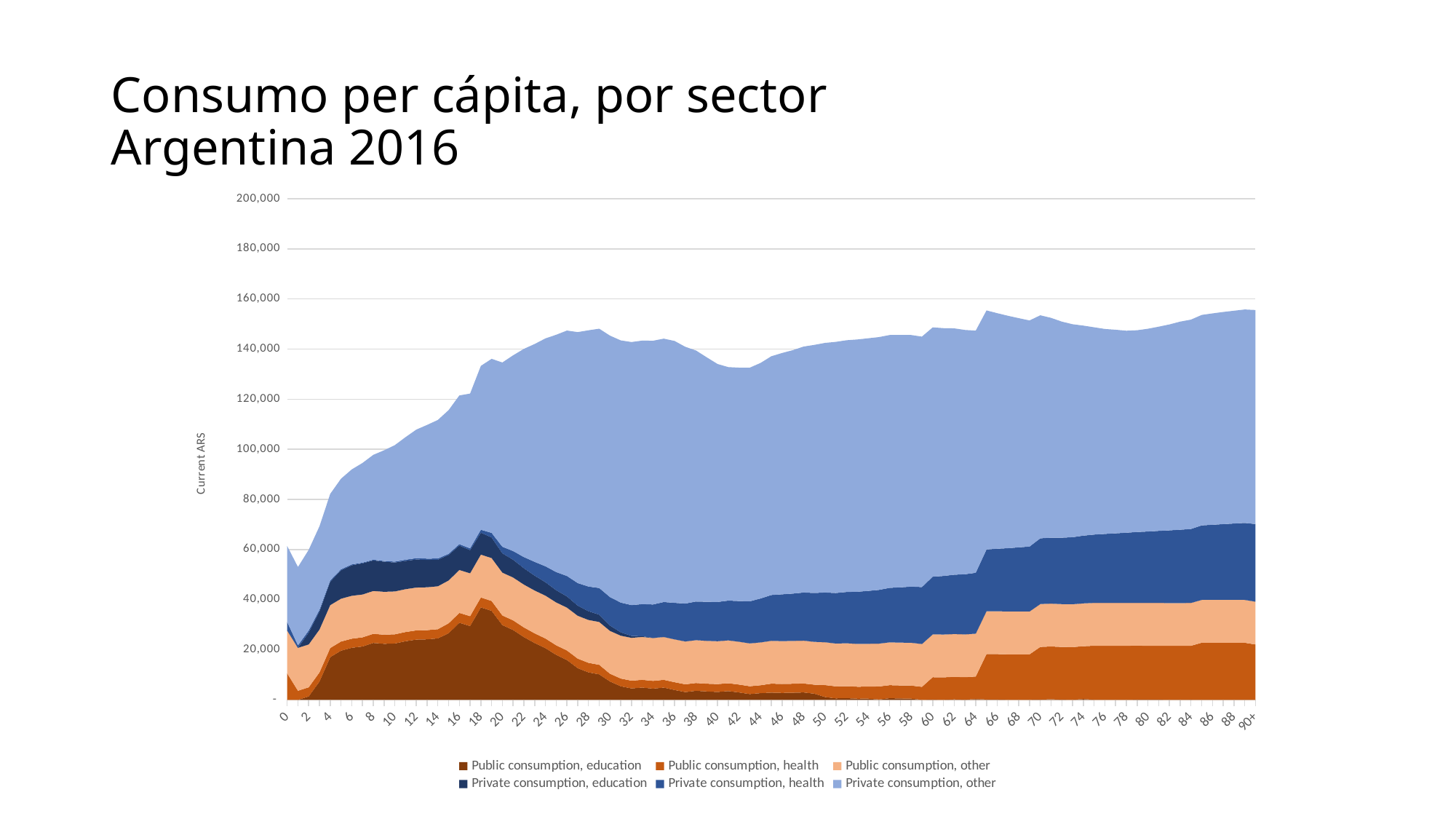
Does the total consumption per capita rise or fall between age 0 and age 26? rise What kind of chart is shown on the slide? Area chart How many series does the legend list? 6 Is the total consumption per capita at age 6 greater or less than 100,000? less Is the total consumption per capita at age 0 greater or less than 40,000? greater At age 90+, which is larger: Public consumption, health or Public consumption, education? Public consumption, health Does the value for Public consumption, education rise or fall between age 18 and age 50? fall Which series accounts for the largest share of consumption at age 40? Private consumption, other What is the label on the vertical axis? Current ARS Is the total consumption per capita at age 66 greater or less than 140,000? greater What is the highest value shown on the vertical axis? 200,000